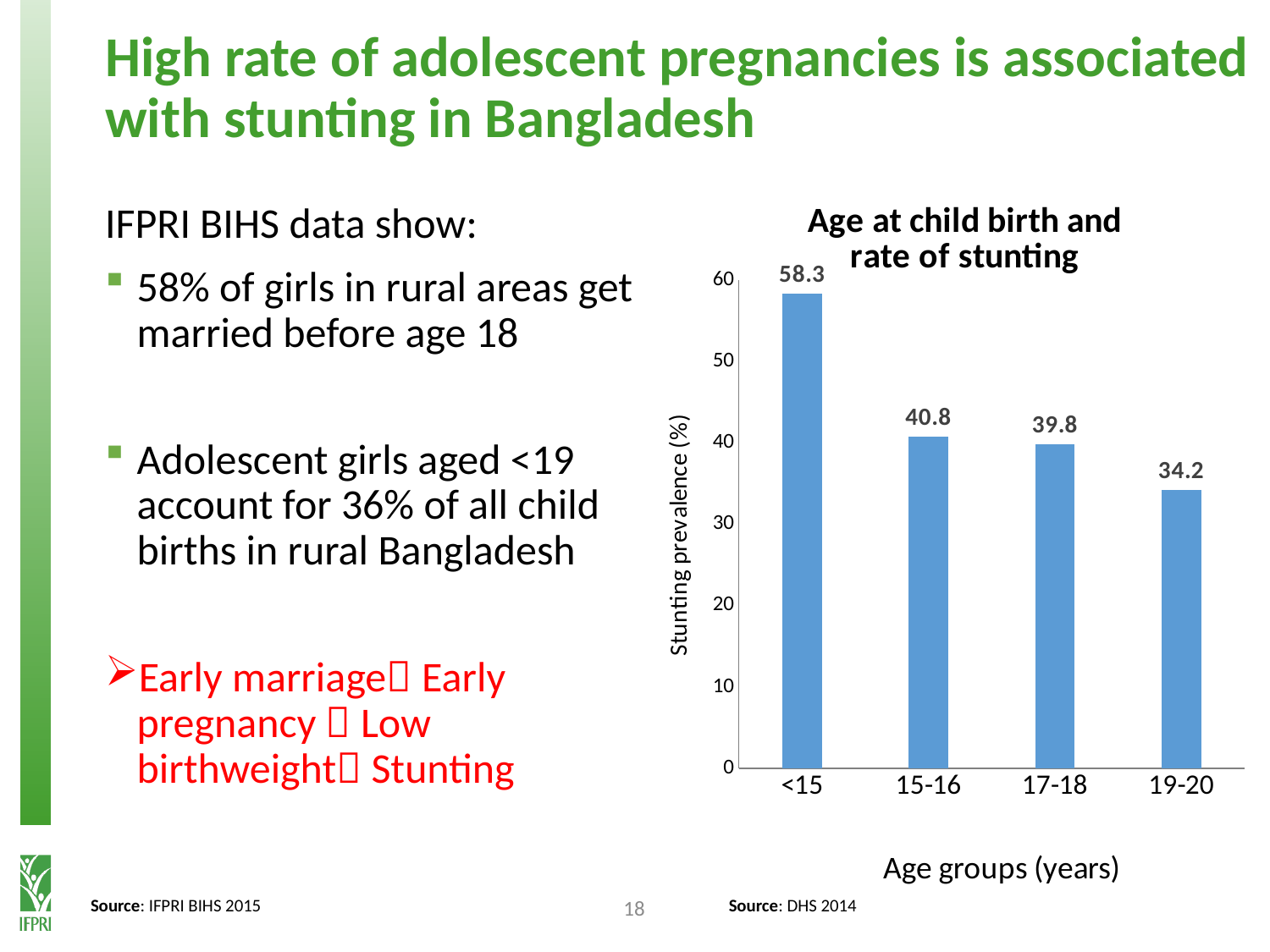
How many age groups are shown in the chart? 4 Which has a higher stunting prevalence, the <15 group or the 17-18 group? <15 What is the stunting prevalence for the 19-20 age group? 34.2 What type of chart is shown on the slide? Bar chart Which age group has the lowest stunting prevalence? 19-20 What is the stunting prevalence for the <15 age group? 58.3 What is the stunting prevalence for the 15-16 age group? 40.8 Which age group has the highest stunting prevalence? <15 Is the stunting prevalence for the 19-20 age group greater or less than 40? less What is the difference in stunting prevalence between the 15-16 and 17-18 age groups? 1.0 What is the difference in stunting prevalence between the <15 and 19-20 age groups? 24.1 Does stunting prevalence rise or fall as the age group at child birth increases? Fall